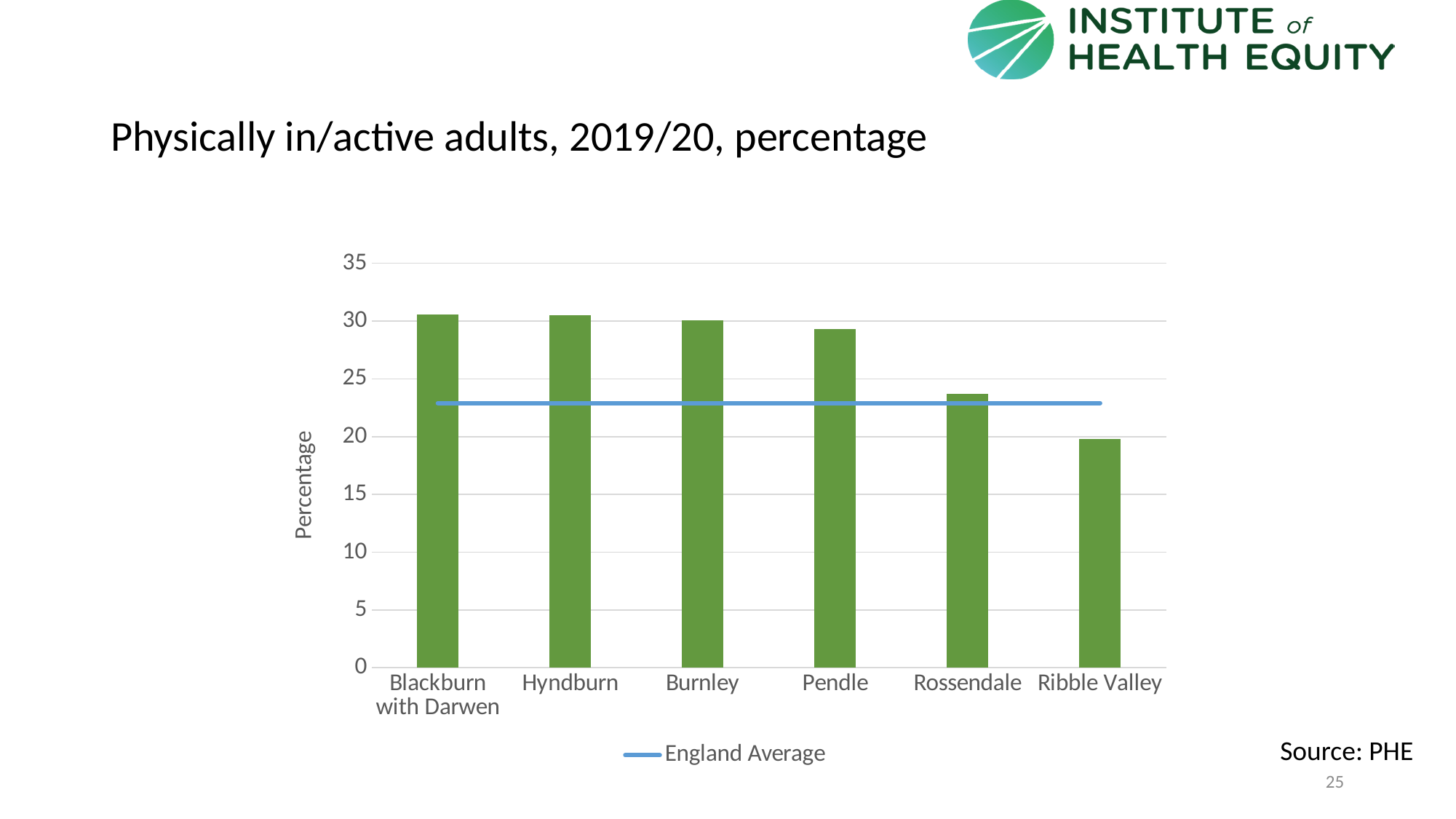
Is the value for Rossendale greater or less than 25? less Is the value for Pendle greater or less than 25? greater How many local authorities are shown on the x axis of the chart? 6 Do the bar values rise or fall from left to right across the x axis? fall What kind of chart is shown on the slide? bar chart Which local authority has the lowest percentage in the chart? Ribble Valley Which has the larger value, Burnley or Ribble Valley? Burnley Which has the larger value, Pendle or Rossendale? Pendle How many entries does the chart's legend list? 1 What does the horizontal blue line in the chart represent, according to the legend? England Average Is the value for Blackburn with Darwen greater or less than 30? greater